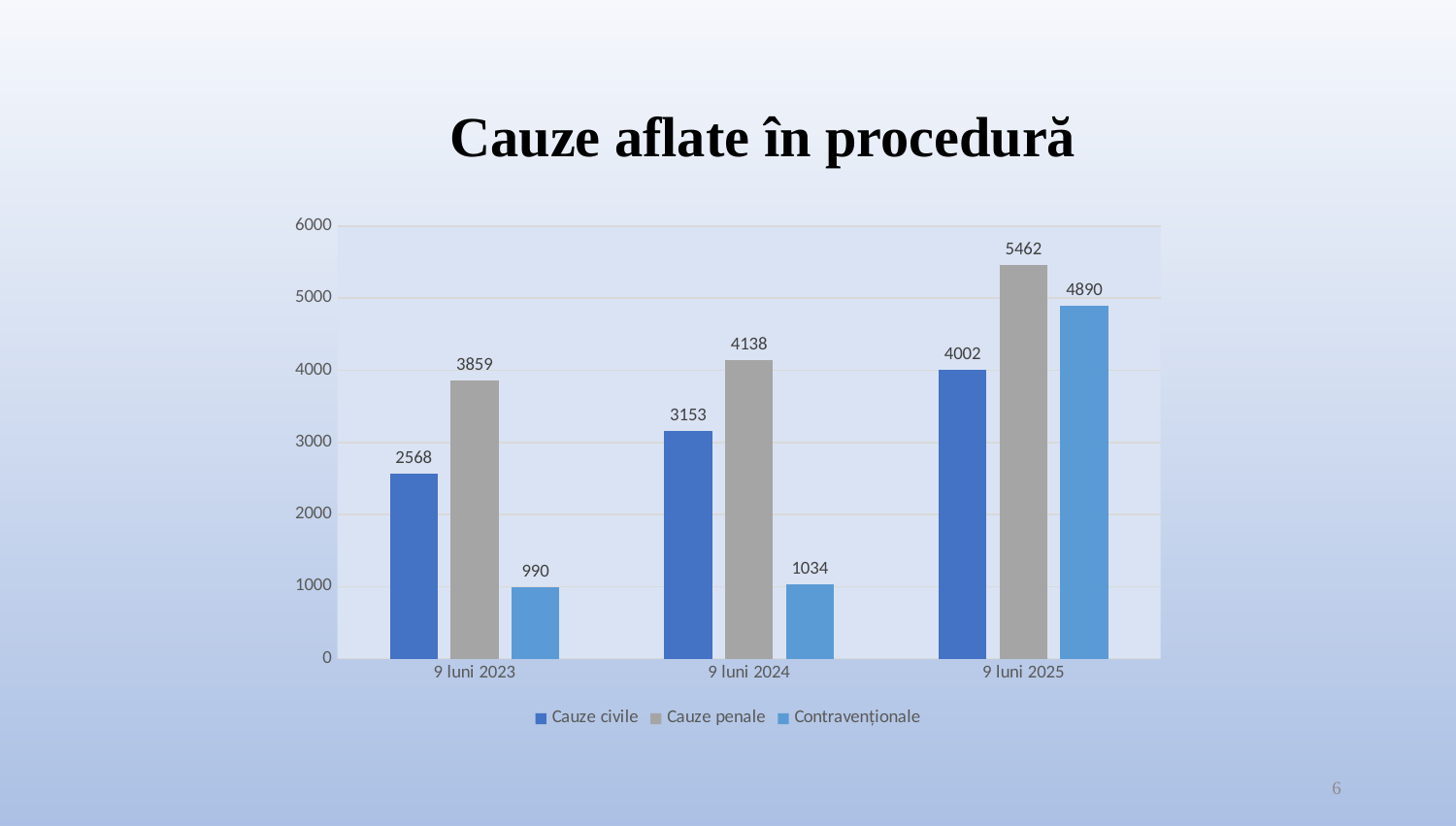
What kind of chart is shown on the slide? bar chart Is the value for Cauze civile in 9 luni 2023 greater or less than 3000? less How many periods are shown on the x axis? 3 Which period has the lowest value for Contravenționale? 9 luni 2023 Which period has the highest value for Cauze penale? 9 luni 2025 Which is larger in 9 luni 2025: Cauze penale or Contravenționale? Cauze penale Do the values for Contravenționale rise or fall from 9 luni 2023 to 9 luni 2025? rise How many series does the legend list? 3 What is the difference between Cauze civile in 9 luni 2025 and 9 luni 2024? 849 What is the value for Contravenționale in 9 luni 2023? 990 What is the value for Cauze penale in 9 luni 2024? 4138 What is the value for Cauze civile in 9 luni 2025? 4002